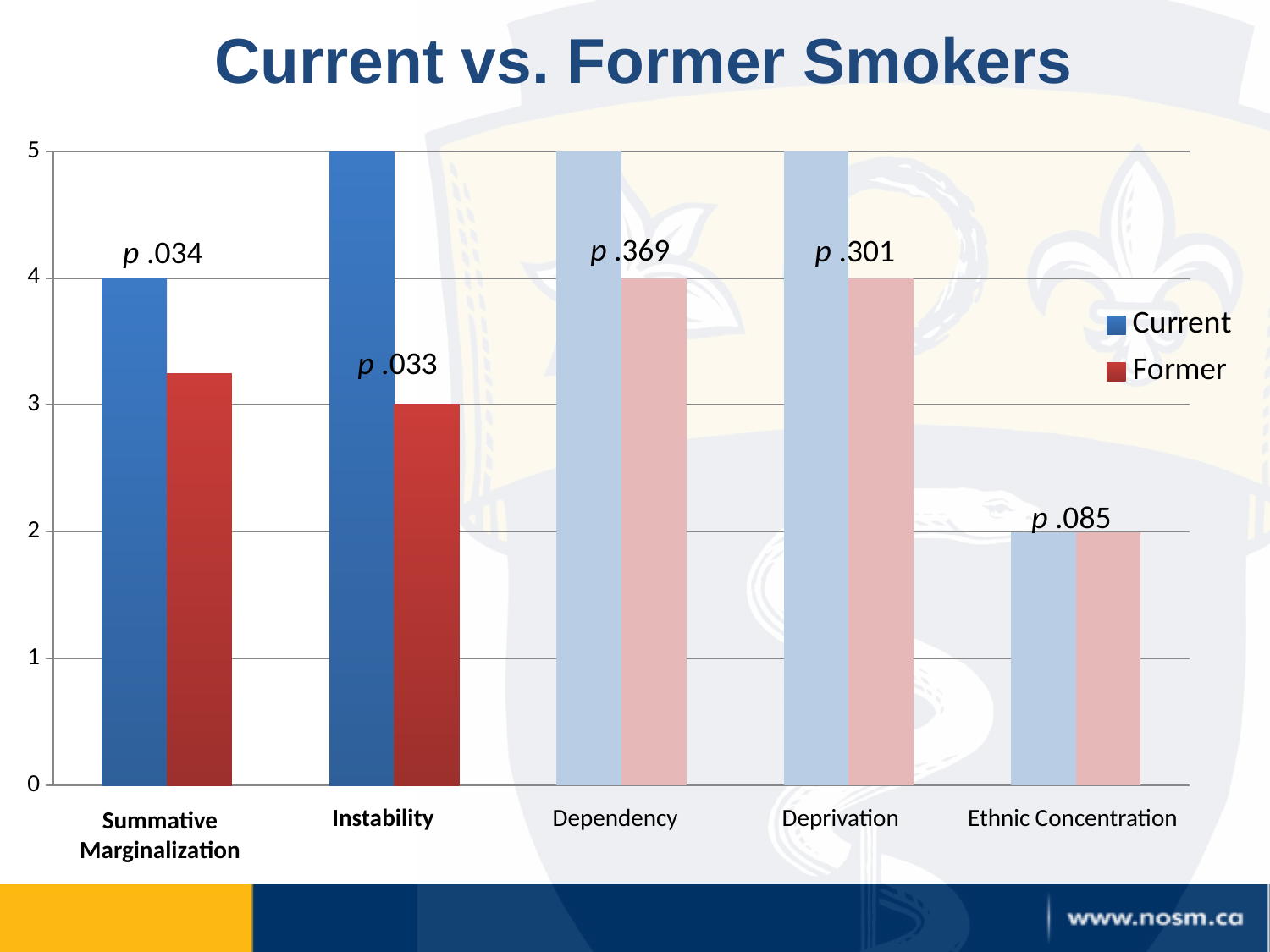
Is the Former value for Summative Marginalization greater or less than 3? greater What is the Former value for Instability? 3 How many categories are shown on the x axis? 5 What kind of chart is shown on the slide? bar chart What is the Current value for Ethnic Concentration? 2 What is the difference between the Current and Former values for Instability? 2 What is the Current value for Summative Marginalization? 4 What p value is printed above the Instability bars? p .033 How many series does the legend list? 2 For Deprivation, which series has the larger value, Current or Former? Current Which category has the lowest Current value? Ethnic Concentration What is the Former value for Dependency? 4